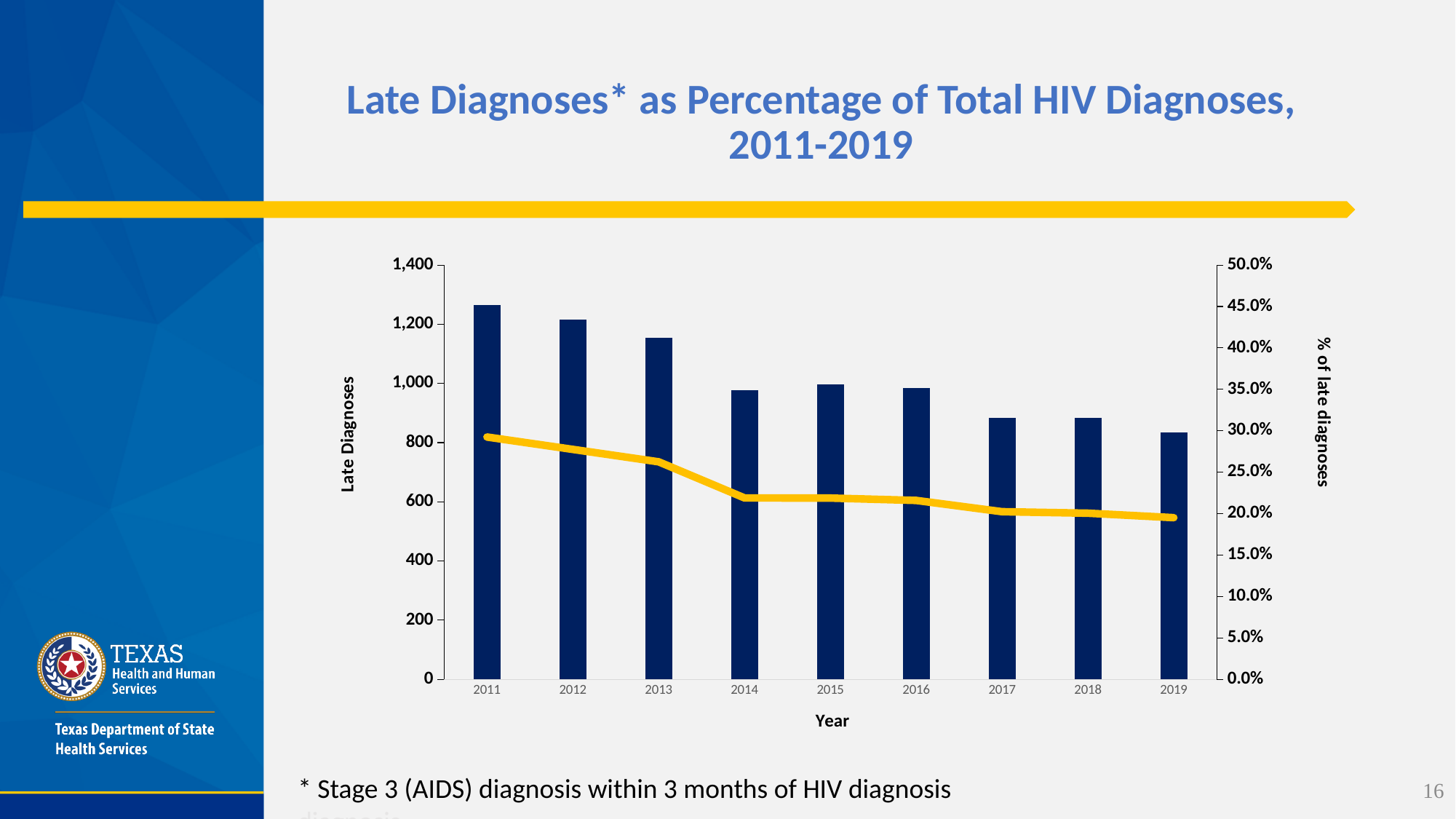
Does the percentage of late diagnoses line generally rise or fall from 2011 to 2019? fall What is the title of the right-hand vertical axis? % of late diagnoses How many years are plotted along the x axis? 9 Is the number of late diagnoses in 2014 greater or less than 1,000? less Is the number of late diagnoses in 2019 greater or less than 800? greater Which year has the highest number of late diagnoses (tallest bar)? 2011 Which year has the lowest number of late diagnoses (shortest bar)? 2019 Is the number of late diagnoses in 2011 greater or less than 1,200? greater Which year has more late diagnoses, 2013 or 2017? 2013 What kind of chart is shown on the slide? A bar chart combined with a line chart